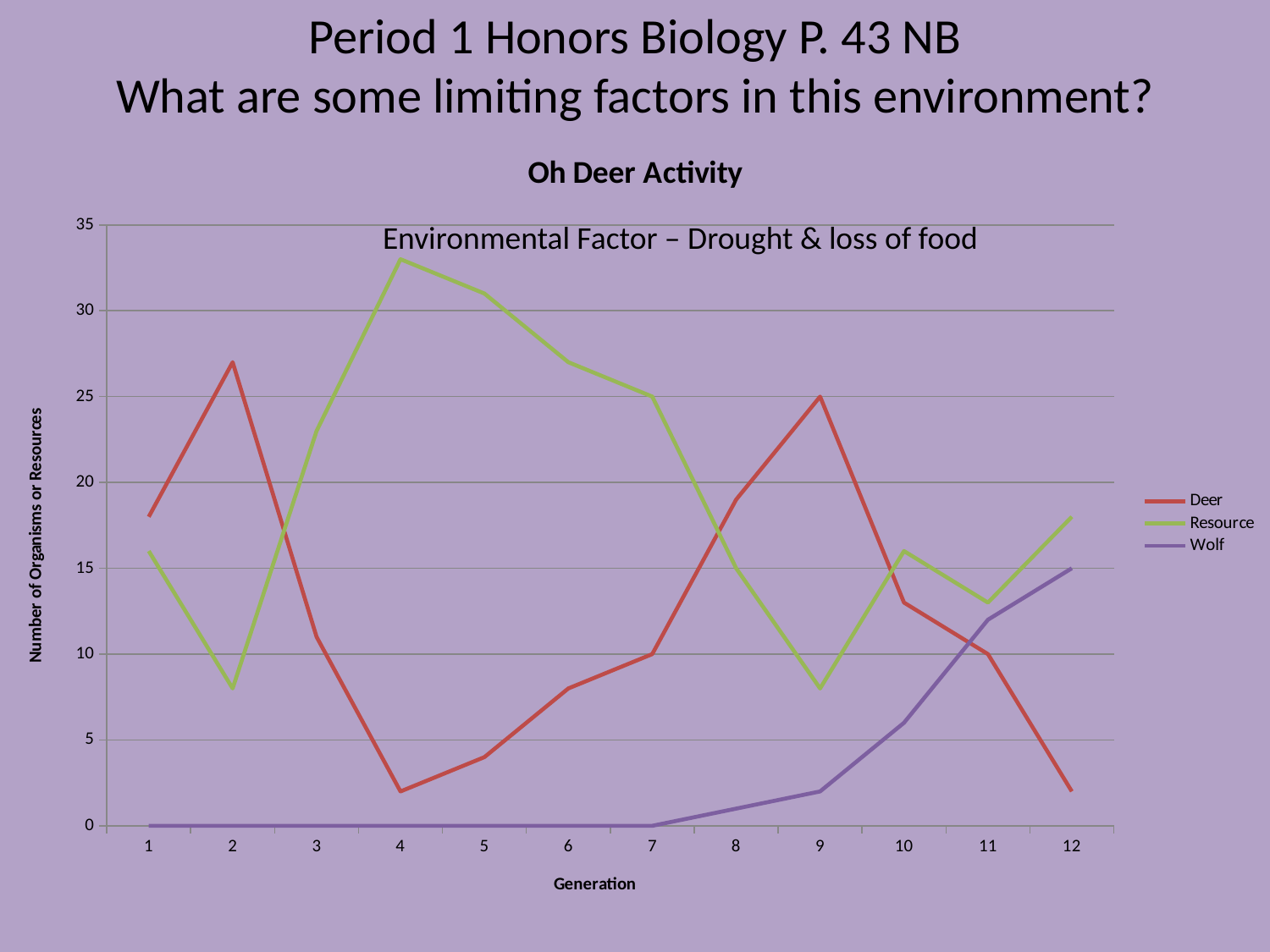
At which generation does the Resource series reach its highest value? 4 Is the Resource value at generation 4 greater or less than 30? greater What is the Wolf value at generation 1? 0 How many generations are plotted along the x axis? 12 How many series does the legend list? 3 What kind of chart is shown on the slide? Line chart Does the Wolf series rise or fall from generation 7 to generation 12? Rise Is the Deer value at generation 4 greater or less than 5? less What is the Deer value at generation 7? 10 At generation 4, which is larger, the Deer value or the Resource value? Resource At which generation does the Deer series reach its highest value? 2 What is the Deer value at generation 9? 25